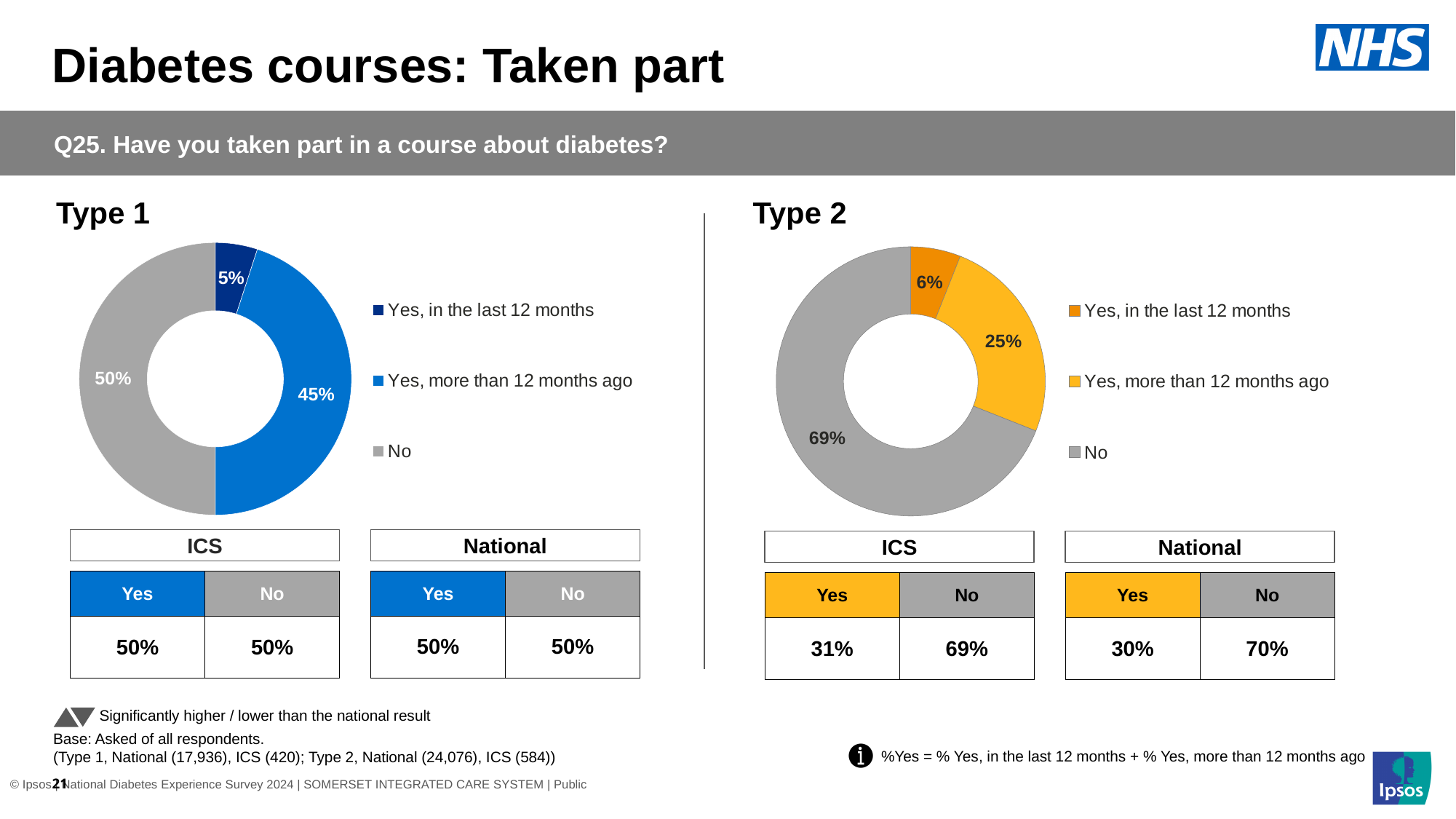
In the Type 2 chart, what percentage answered 'No'? 69% In the Type 1 chart, what percentage answered 'No'? 50% In the Type 2 chart, what is the difference between the 'No' share and the 'Yes, more than 12 months ago' share? 44% In the Type 2 chart, which category has the largest share? No In the Type 2 chart, what percentage answered 'Yes, more than 12 months ago'? 25% In the Type 1 chart, what percentage answered 'Yes, more than 12 months ago'? 45% In the Type 2 chart, what percentage answered 'Yes, in the last 12 months'? 6% Which is larger in the Type 1 chart: 'Yes, more than 12 months ago' or 'Yes, in the last 12 months'? Yes, more than 12 months ago How many categories does the legend of the Type 2 chart list? 3 In the Type 1 chart, which category has the smallest share? Yes, in the last 12 months What type of chart is used for Type 1? Doughnut chart In the Type 1 chart, what percentage answered 'Yes, in the last 12 months'? 5%